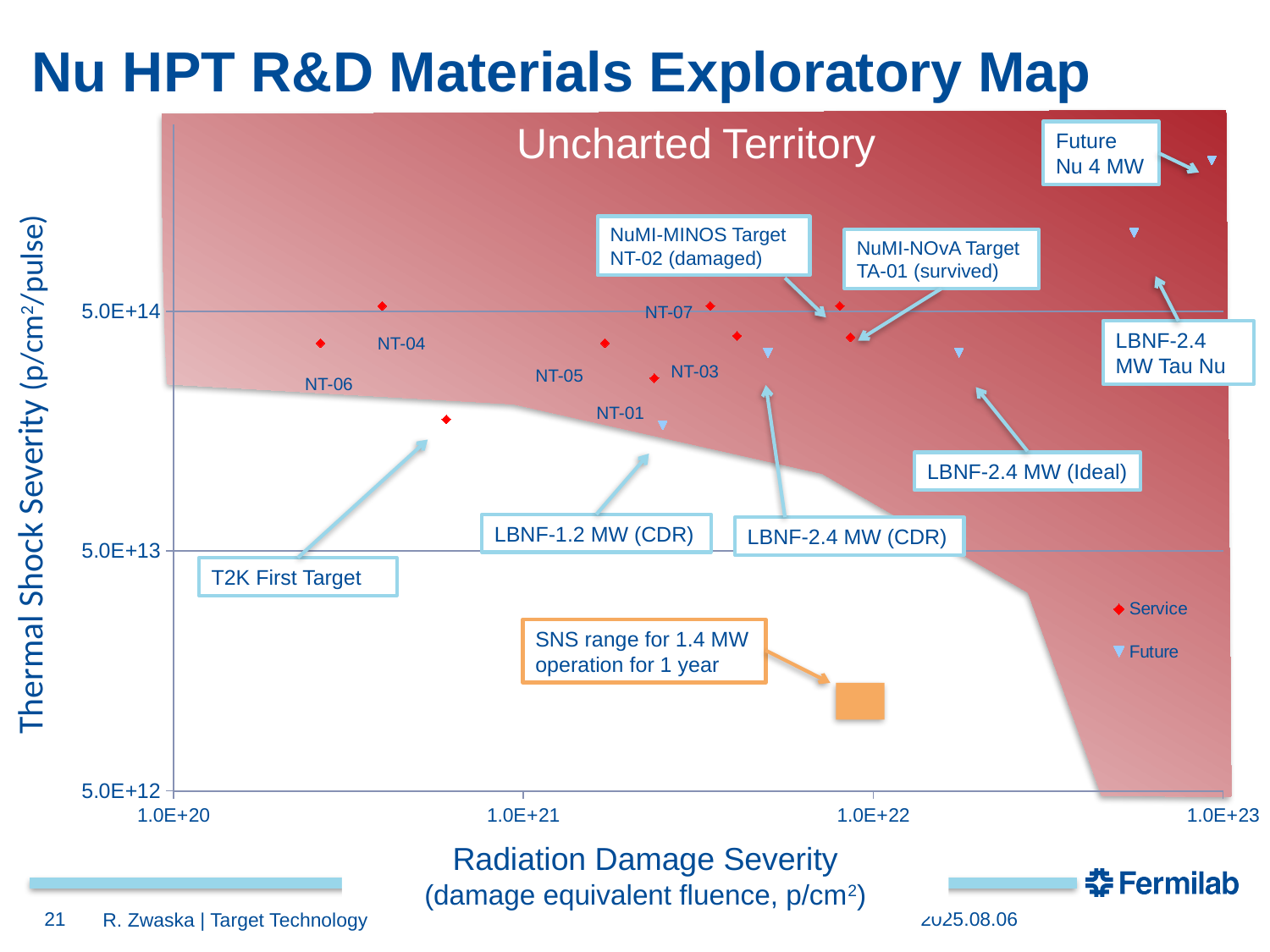
Is the Radiation Damage Severity for the T2K First Target greater or less than 1.0E+21? less What are the two series named in the legend? Service and Future How many series does the legend list? 2 Is the Thermal Shock Severity for the T2K First Target greater or less than 5.0E+13? greater Which labeled point has the highest Thermal Shock Severity? Future Nu 4 MW What does the orange square on the chart represent? SNS range for 1.4 MW operation for 1 year Is the Thermal Shock Severity for NT-06 greater or less than 5.0E+14? less Which has the higher Thermal Shock Severity, Future Nu 4 MW or the T2K First Target? Future Nu 4 MW What kind of chart is shown on the slide? scatter chart